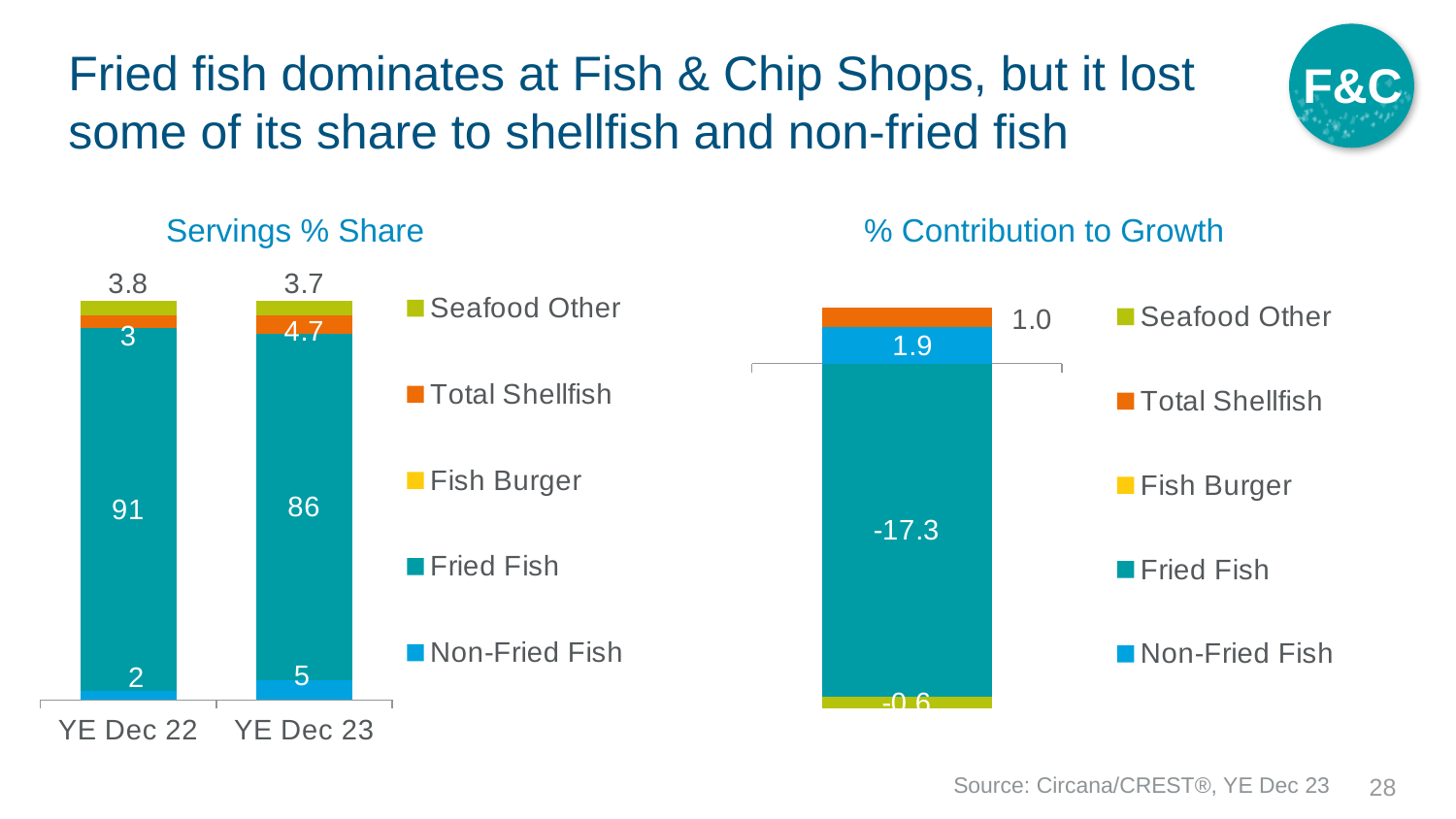
How many series does the legend of the Servings % Share chart list? 5 In the % Contribution to Growth chart, which series has the lowest value? Fried Fish In the % Contribution to Growth chart, what is the value for Non-Fried Fish? 1.9 In the Servings % Share chart, what is the value for Fried Fish in YE Dec 22? 91 In the Servings % Share chart, what is the value for Fried Fish in YE Dec 23? 86 In the Servings % Share chart, which year has the larger Non-Fried Fish share, YE Dec 22 or YE Dec 23? YE Dec 23 In the Servings % Share chart, what is the value for Total Shellfish in YE Dec 23? 4.7 In the % Contribution to Growth chart, what is the value for Fried Fish? -17.3 In the Servings % Share chart, by how much did the Fried Fish share fall from YE Dec 22 to YE Dec 23? 5 In the Servings % Share chart, what is the value for Non-Fried Fish in YE Dec 23? 5 How many categories are shown on the x axis of the Servings % Share chart? 2 What kind of chart is the Servings % Share chart? Stacked bar chart